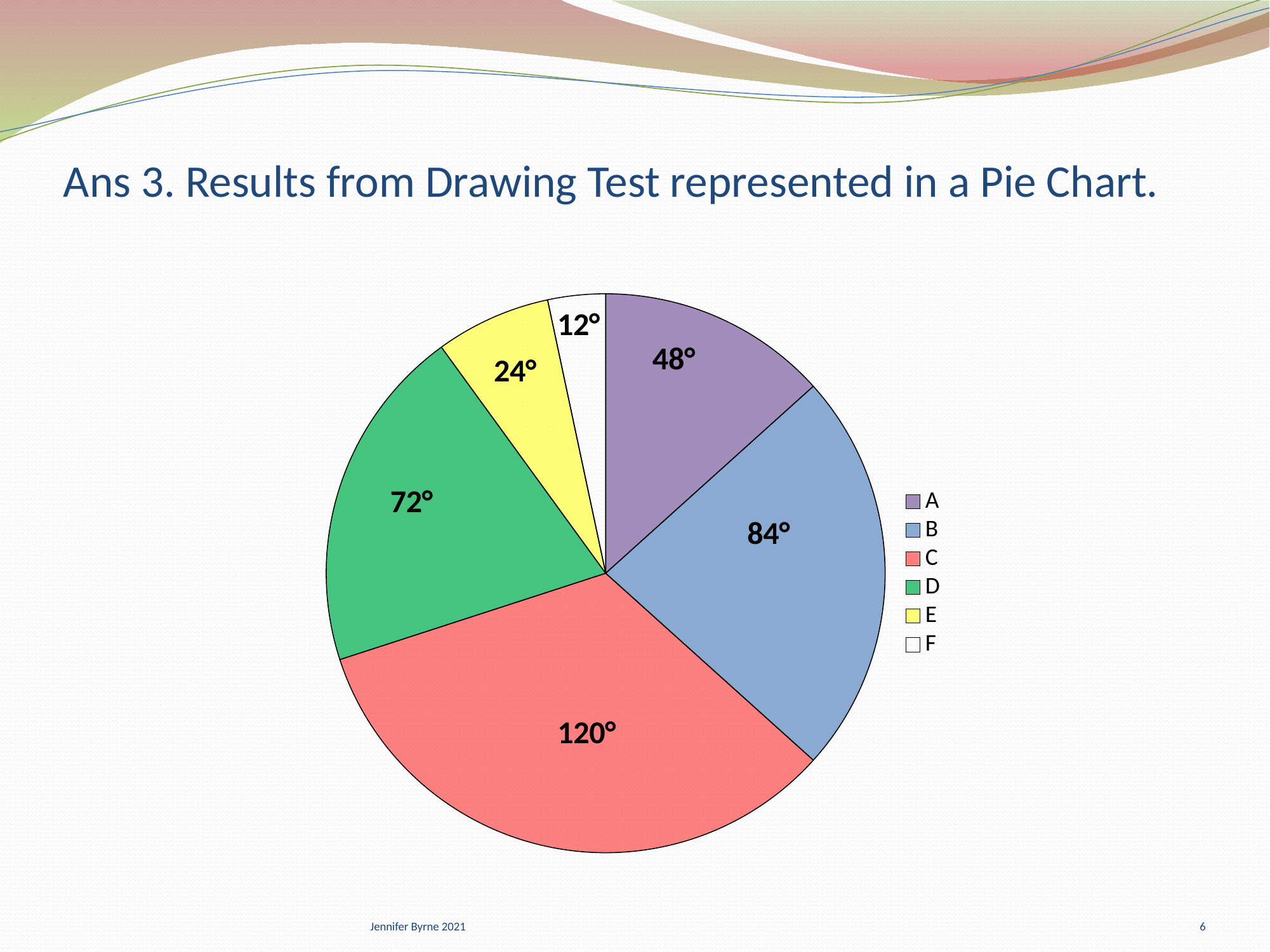
What share of the pie does the slice for C represent? one third Which is larger, the slice for D or the slice for A? D Which category has the smallest slice? F What is the value labelled on the slice for C? 120° What is the difference between the values for B and D? 12° What is the value labelled on the slice for E? 24° Which category has the largest slice? C How many slices does the pie chart have? 6 What is the value labelled on the slice for A? 48° How many entries does the legend list? 6 What kind of chart is shown on the slide? pie chart What colour is the slice for D? green